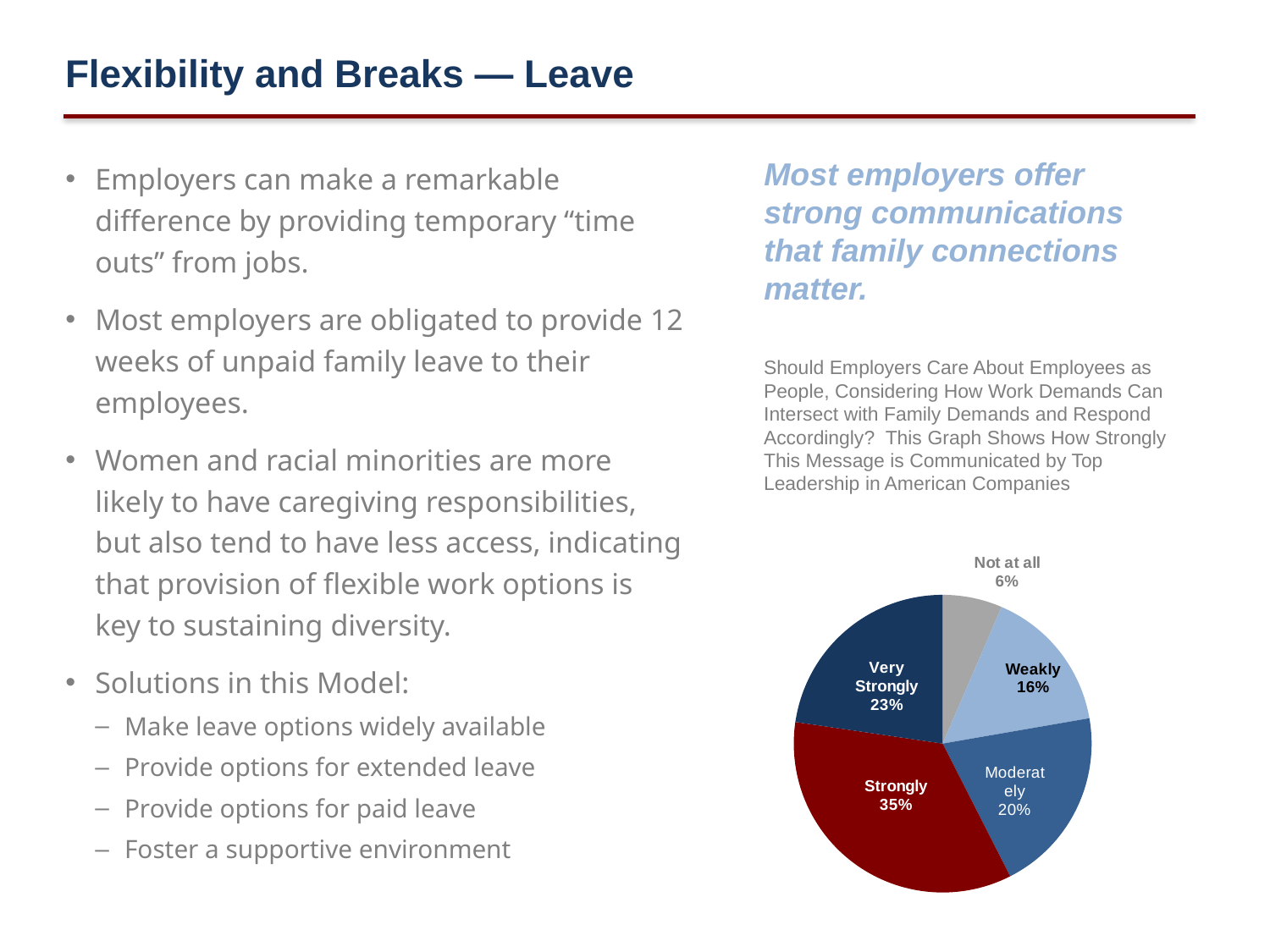
What colour is the "Strongly" slice of the pie? Dark red How many slices does the pie chart have? 5 Which slice is larger, "Moderately" or "Weakly"? Moderately What kind of chart is shown on the slide? Pie chart What is the combined share of the "Strongly" and "Very Strongly" slices? 58% What percentage is shown for the "Very Strongly" slice? 23% What percentage is shown for the "Not at all" slice? 6% Which category has the smallest share of the pie? Not at all What share of the pie does the "Strongly" slice represent? 35% Which category has the largest share of the pie? Strongly What percentage is shown for the "Weakly" slice? 16% What is the difference in percentage points between the "Strongly" and "Very Strongly" slices? 12